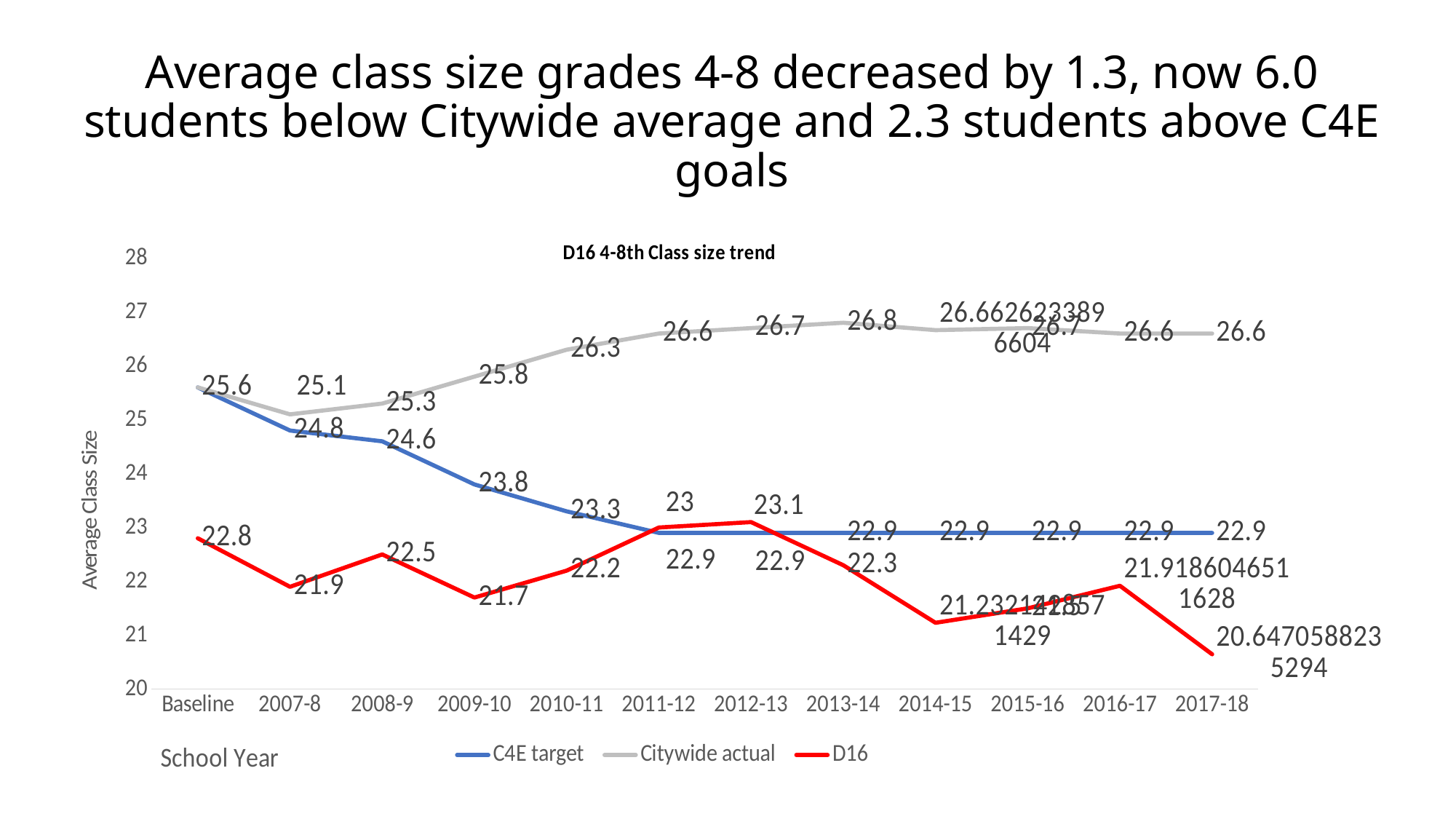
What is the difference between the Citywide actual and D16 values in 2013-14? 4.5 What is the D16 value at Baseline? 22.8 What kind of chart is shown on the slide? Line chart What is the Citywide actual value for 2013-14? 26.8 How many series does the legend list? 3 In which school year is the Citywide actual value highest? 2013-14 In which school year is the D16 value lowest? 2017-18 Which is larger in 2011-12, the Citywide actual value or the C4E target value? Citywide actual Is the D16 value for 2017-18 greater or less than 21? less What is the C4E target value for 2009-10? 23.8 What colour is the D16 line in the legend? Red How many school-year categories are plotted on the x axis? 12